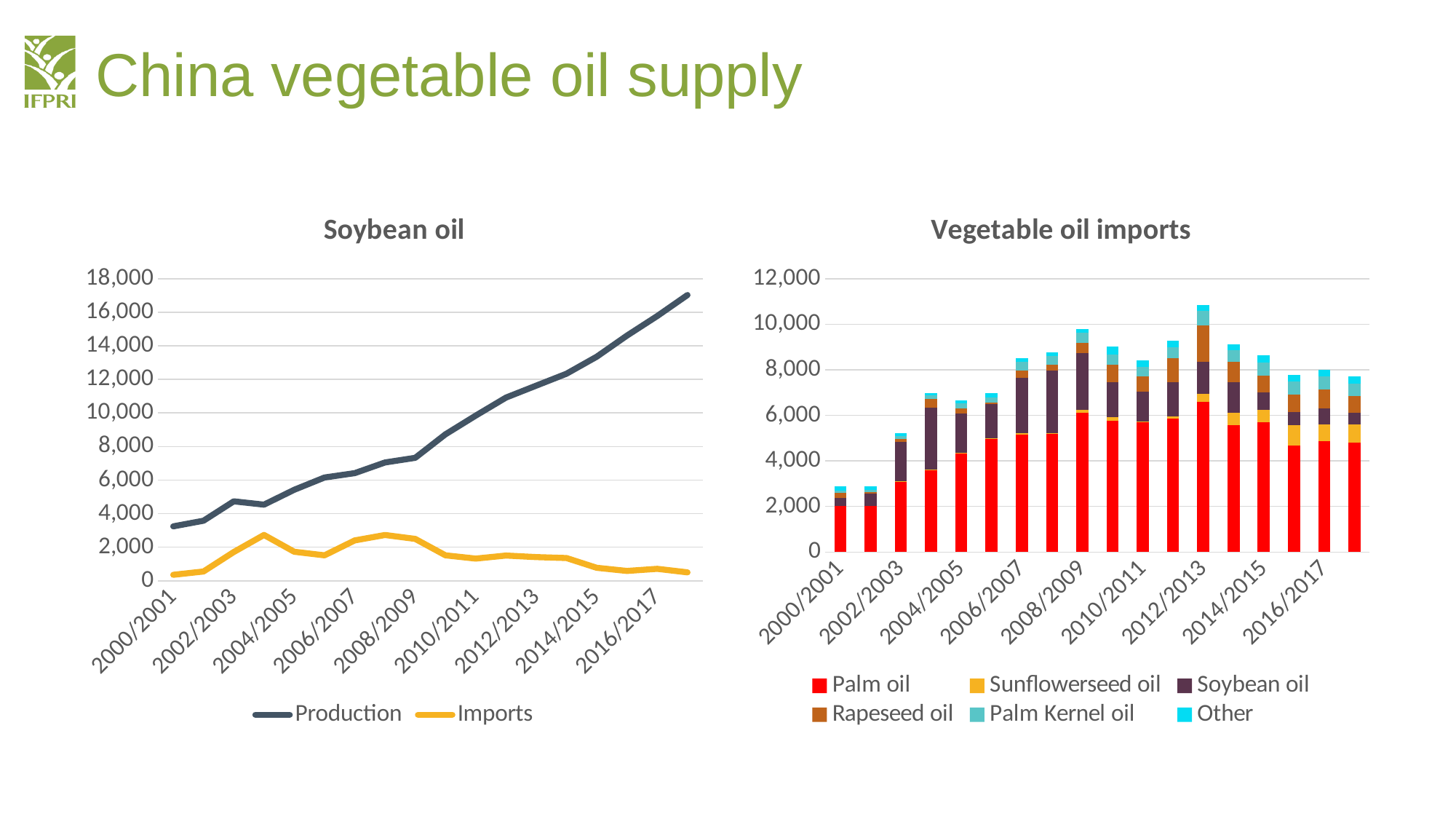
In the Soybean oil chart, is the Production value for 2016/2017 greater or less than 12,000? greater What type of chart is the Vegetable oil imports chart? bar chart What type of chart is the Soybean oil chart? line chart In the Soybean oil chart, is the Production value for 2000/2001 greater or less than 4,000? less In the Vegetable oil imports chart, which series is shown in red? Palm oil In the Soybean oil chart, is the Imports value for 2016/2017 greater or less than 2,000? less How many series does the legend of the Vegetable oil imports chart list? 6 In the Soybean oil chart, does Production rise or fall over the years shown? rise In the Vegetable oil imports chart, which year has the tallest stacked bar? 2012/2013 How many series does the legend of the Soybean oil chart list? 2 In the Vegetable oil imports chart, how many years (bars) are plotted? 18